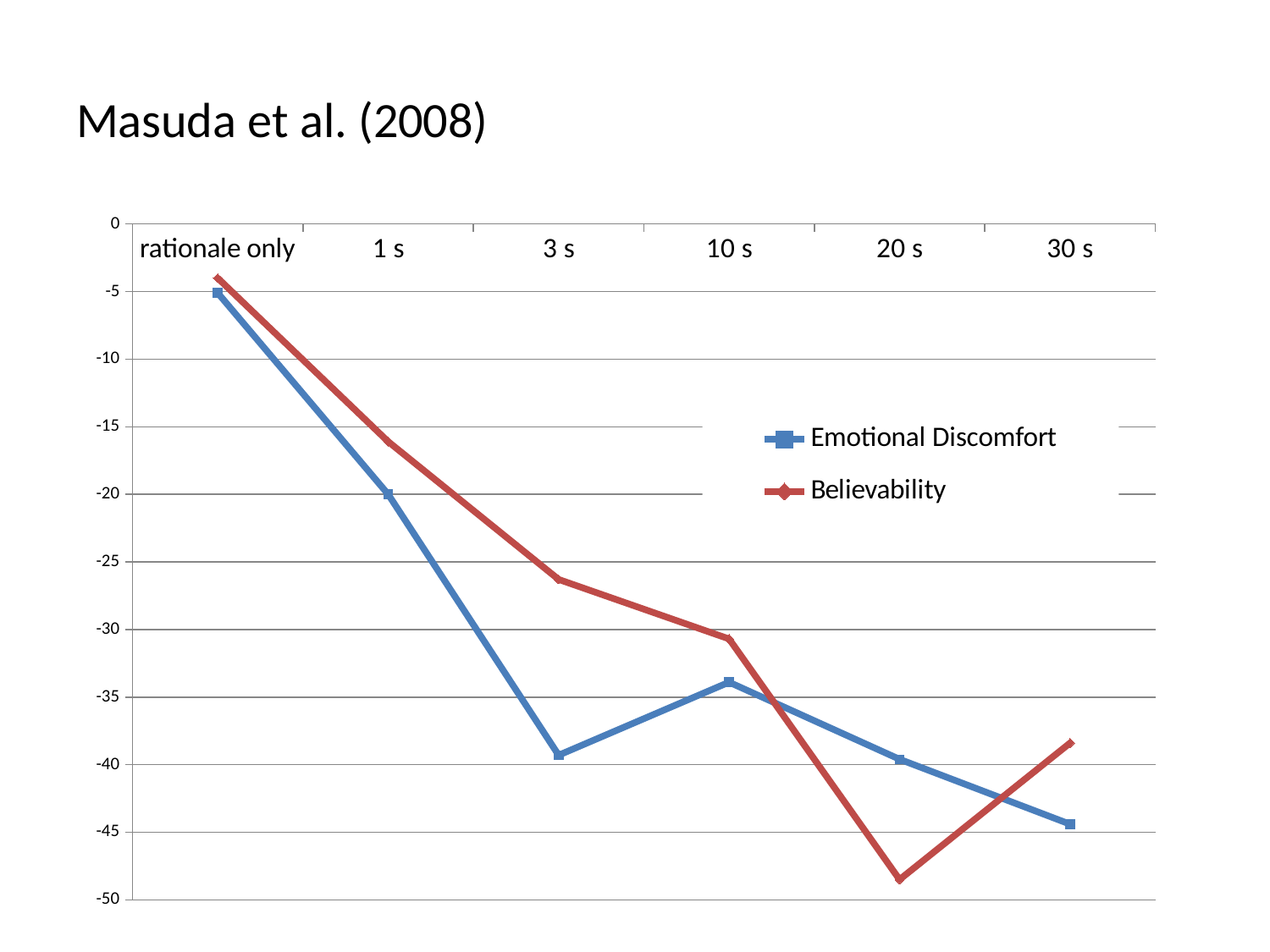
At 20 s, which series has the higher value, Emotional Discomfort or Believability? Emotional Discomfort At which category is Believability lowest? 20 s At 3 s, which series has the higher value, Emotional Discomfort or Believability? Believability Is the value of Emotional Discomfort at 3 s greater or less than -35? less How many series does the legend list? 2 At which category is Emotional Discomfort lowest? 30 s Is the value of Believability at 20 s greater or less than -45? less How many categories are shown along the x axis? 6 What is the value of Emotional Discomfort at 1 s? -20 What kind of chart is shown on the slide? line chart Which series is drawn in red? Believability Is the value of Believability at 3 s greater or less than -30? greater